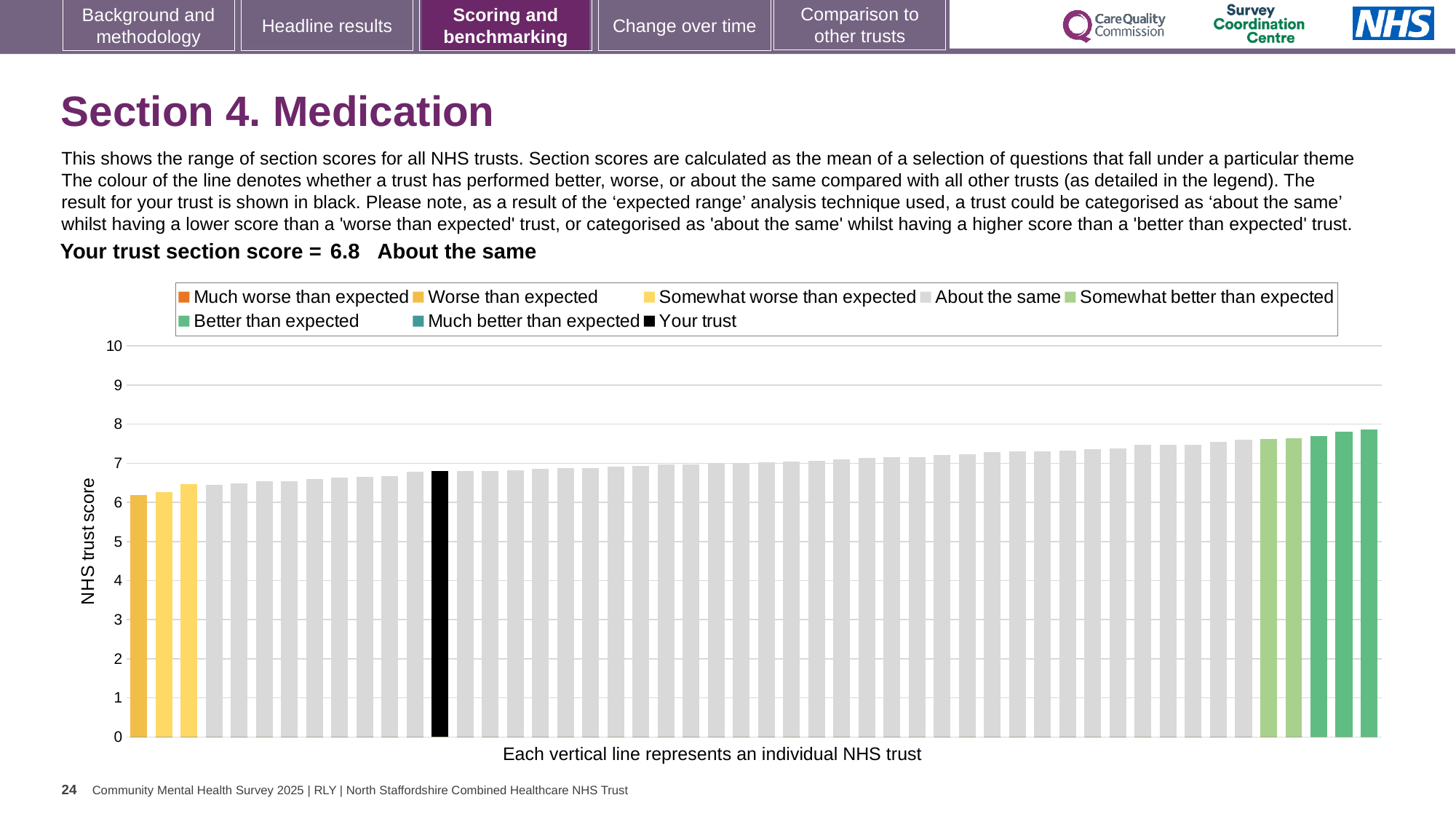
According to the legend, what colour is used for your trust's bar? black Is the value of the black bar (your trust) greater or less than 5? greater How many bars on the left of the chart are coloured yellow? 3 Is the value of the tallest bar greater or less than 7? greater What is the section score for your trust shown on the slide? 6.8 What kind of chart is shown on the slide? bar chart What is the highest value shown on the vertical axis? 10 Which category is your trust's section score placed in? About the same Do the bar values rise or fall from left to right along the x axis? rise Is the value of the shortest bar greater or less than 7? less What is the title of the vertical axis? NHS trust score How many entries does the chart legend list? 8